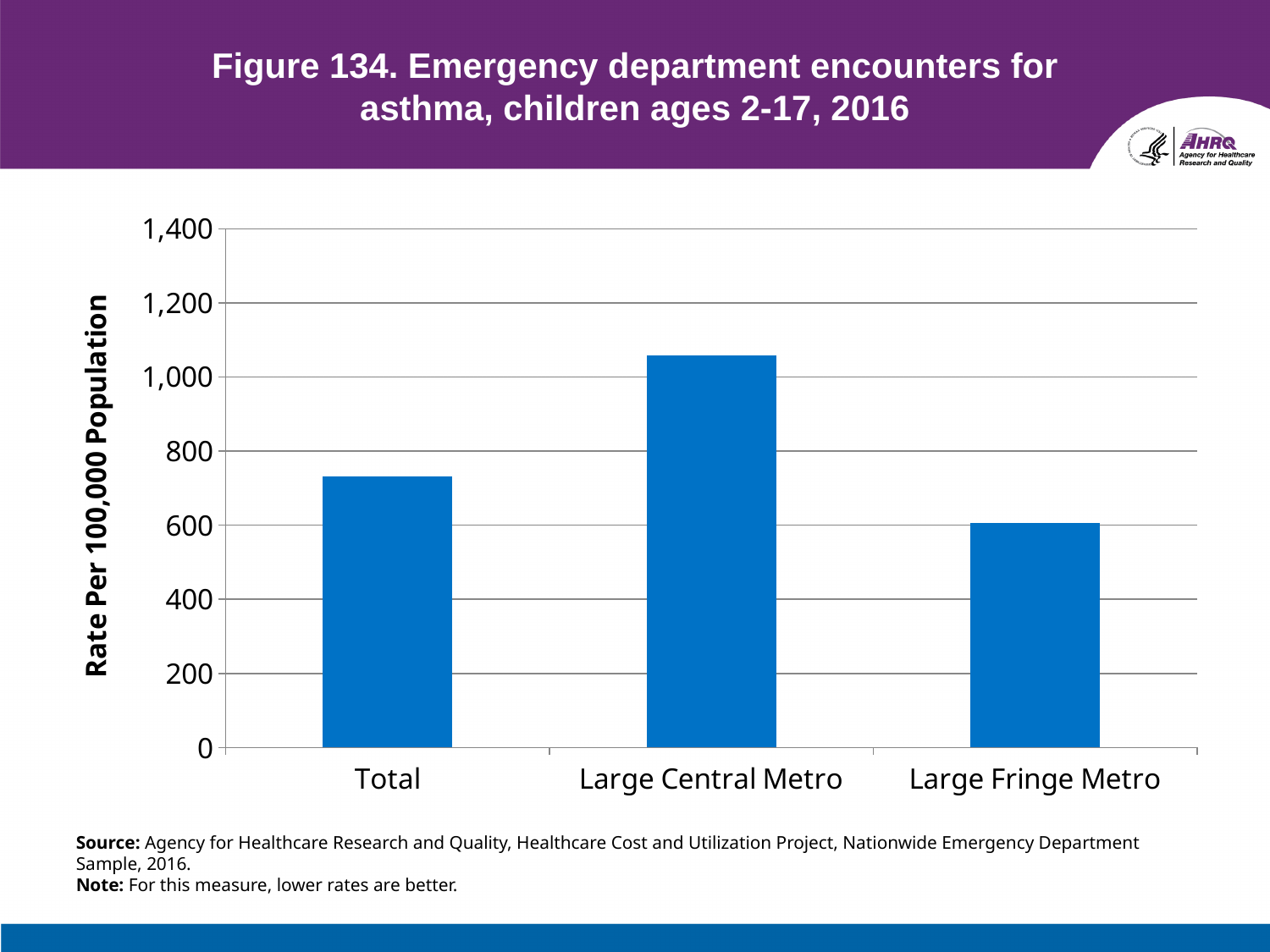
Which is larger, the rate for Large Central Metro or the rate for Total? Large Central Metro Is the value for Large Fringe Metro greater or less than 800? less Is the value for Large Central Metro greater or less than 1,000? greater What is the label of the vertical axis of the chart? Rate Per 100,000 Population Is the value for Total greater or less than 600? greater What is the maximum value shown on the vertical axis of the chart? 1,400 Which category has the lowest rate of emergency department encounters for asthma? Large Fringe Metro What kind of chart is shown on the slide? Bar chart Which is larger, the rate for Total or the rate for Large Fringe Metro? Total How many categories are shown on the x axis of the chart? 3 Which category has the highest rate of emergency department encounters for asthma? Large Central Metro